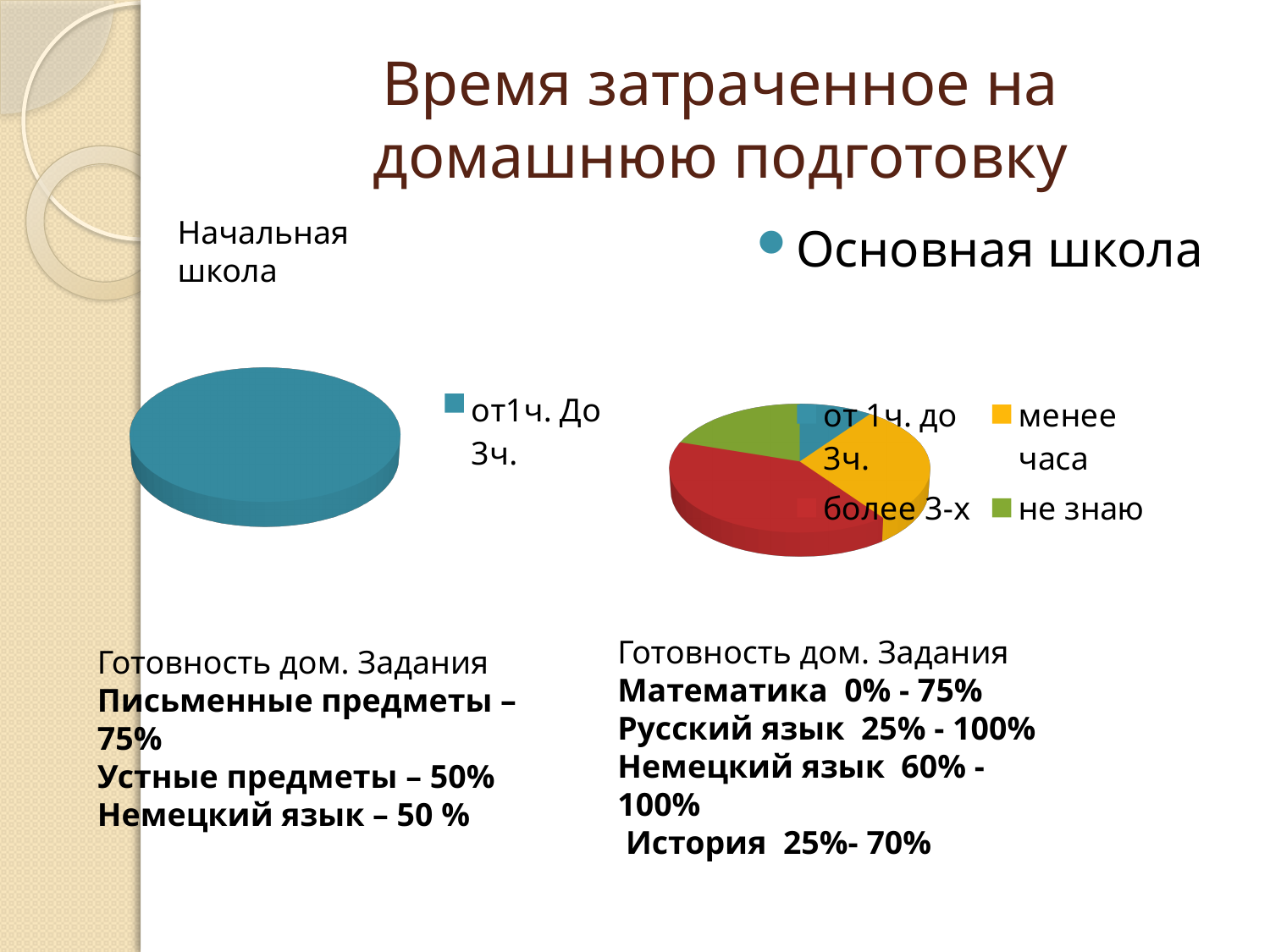
In the right chart "Основная школа", how many categories does the legend list? 4 In the right chart "Основная школа", what colour is the slice for "не знаю"? green What kind of chart is the right chart titled "Основная школа"? pie chart In the right chart "Основная школа", which slice is larger: "менее часа" or "от 1ч. до 3ч."? менее часа In the right chart "Основная школа", which slice is larger: "более 3-х" or "не знаю"? более 3-х In the right chart "Основная школа", which category has the smallest slice? от 1ч. до 3ч. In the left chart "Начальная школа", what is the only category shown in the legend? от1ч. До 3ч. What kind of chart is the left chart titled "Начальная школа"? pie chart In the left chart "Начальная школа", how many categories does the legend list? 1 In the right chart "Основная школа", how many slices does the pie have? 4 In the right chart "Основная школа", which category has the largest slice? более 3-х